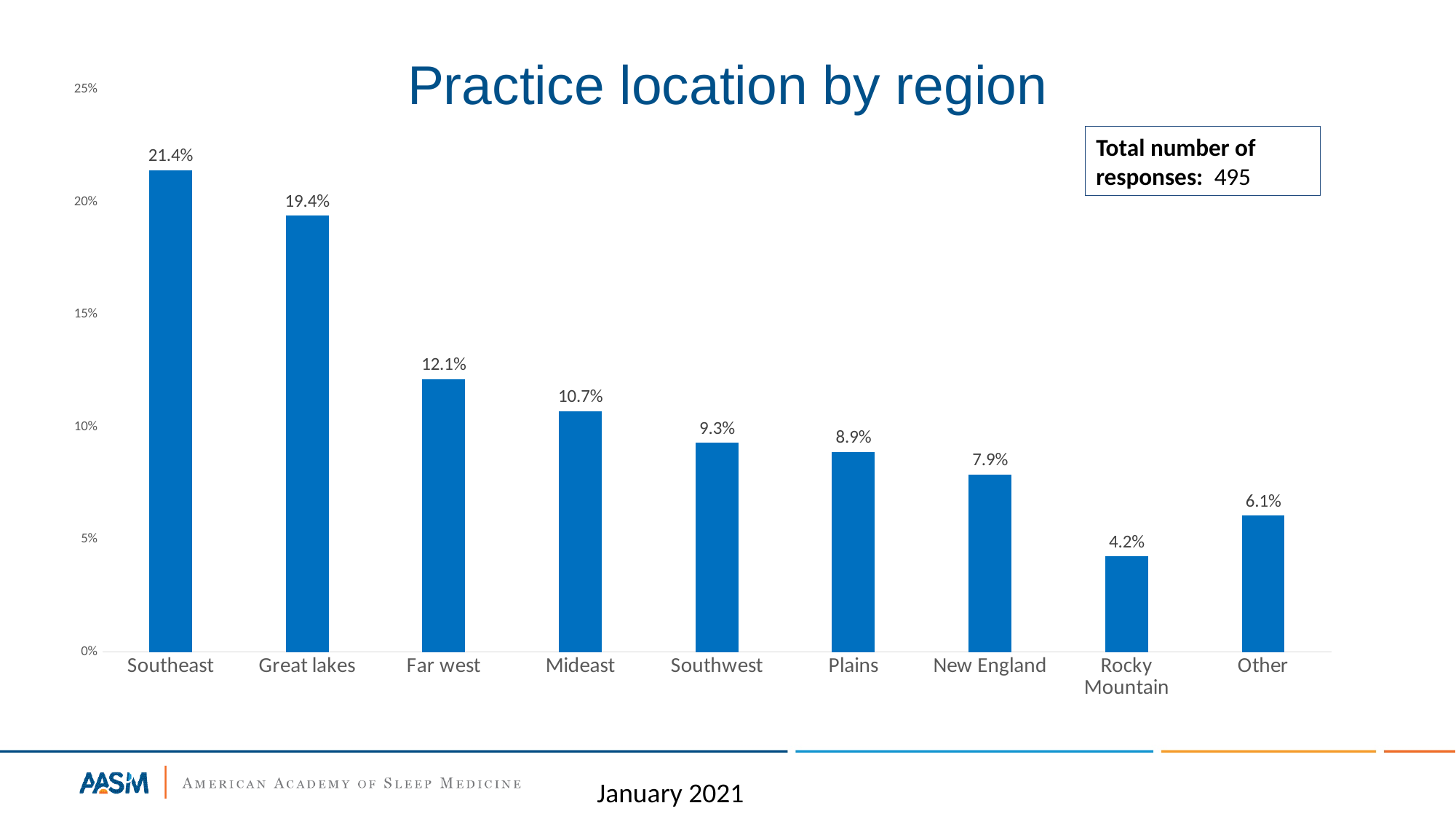
What is the value for Mideast? 10.7% What is the value for Rocky Mountain? 4.2% Which region has the highest value? Southeast What is the title of the chart? Practice location by region What kind of chart is shown on the slide? bar chart Do the values generally rise or fall from left to right along the x axis? fall Which is larger, the value for Far west or the value for Southwest? Far west Which region has the lowest value? Rocky Mountain What is the difference between the values for Southeast and Great lakes? 2.0% What is the value for Southeast? 21.4% Is the value for New England greater or less than 10%? less How many regions are shown on the x axis? 9